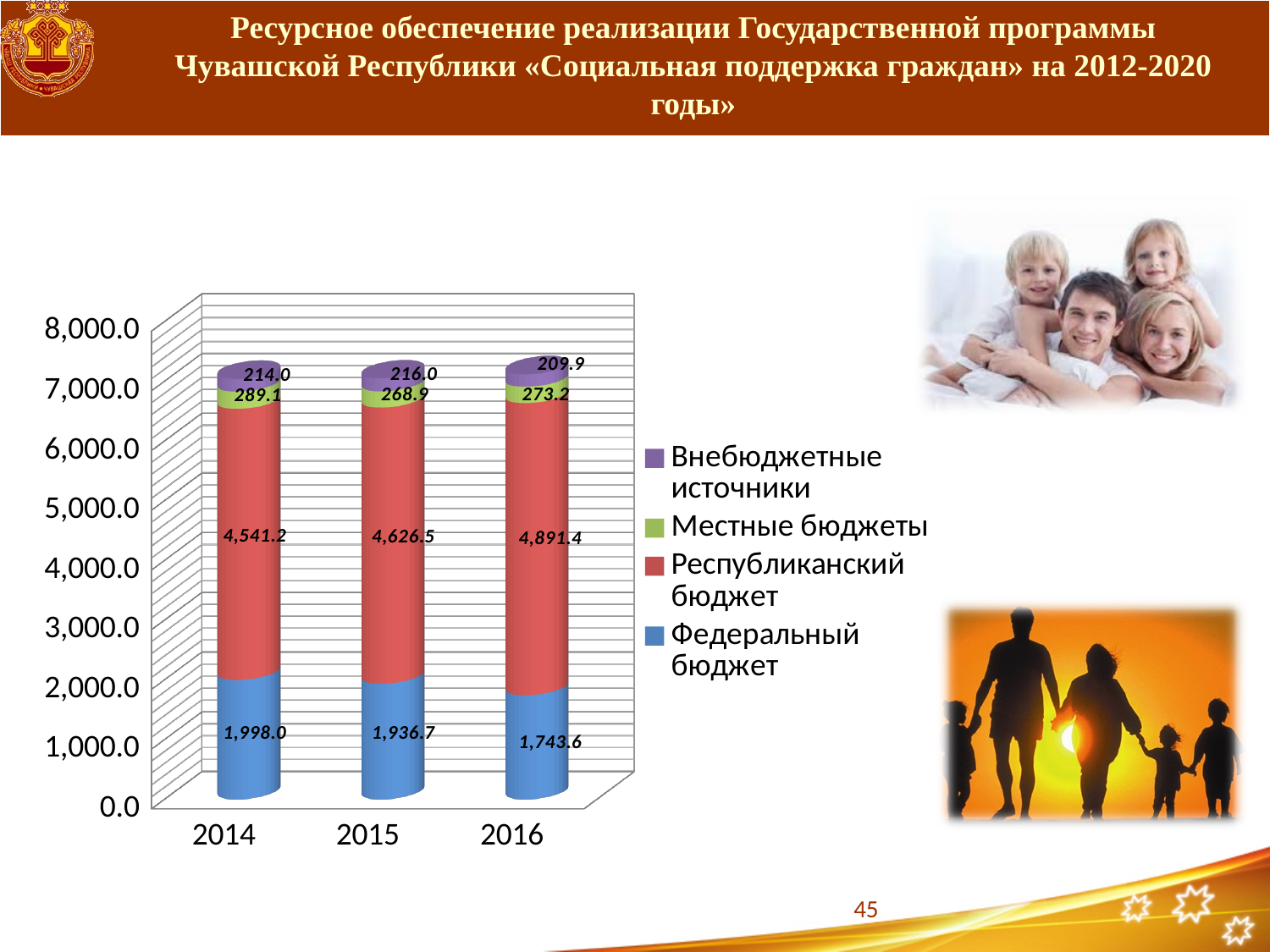
In which year is the Федеральный бюджет value the lowest? 2016 How many series does the legend list? 4 What is the value for Местные бюджеты in 2015? 268.9 What is the value for Республиканский бюджет in 2016? 4,891.4 What is the value for Федеральный бюджет in 2014? 1,998.0 What is the total of the stacked bar for 2014? 7,042.3 What is the difference between the Республиканский бюджет values for 2016 and 2014? 350.2 What is the value for Внебюджетные источники in 2016? 209.9 What kind of chart is shown on the slide? Stacked bar chart Which is larger, the Федеральный бюджет value for 2014 or for 2015? 2014 In which year is the Республиканский бюджет value the highest? 2016 How many years are shown on the x axis? 3